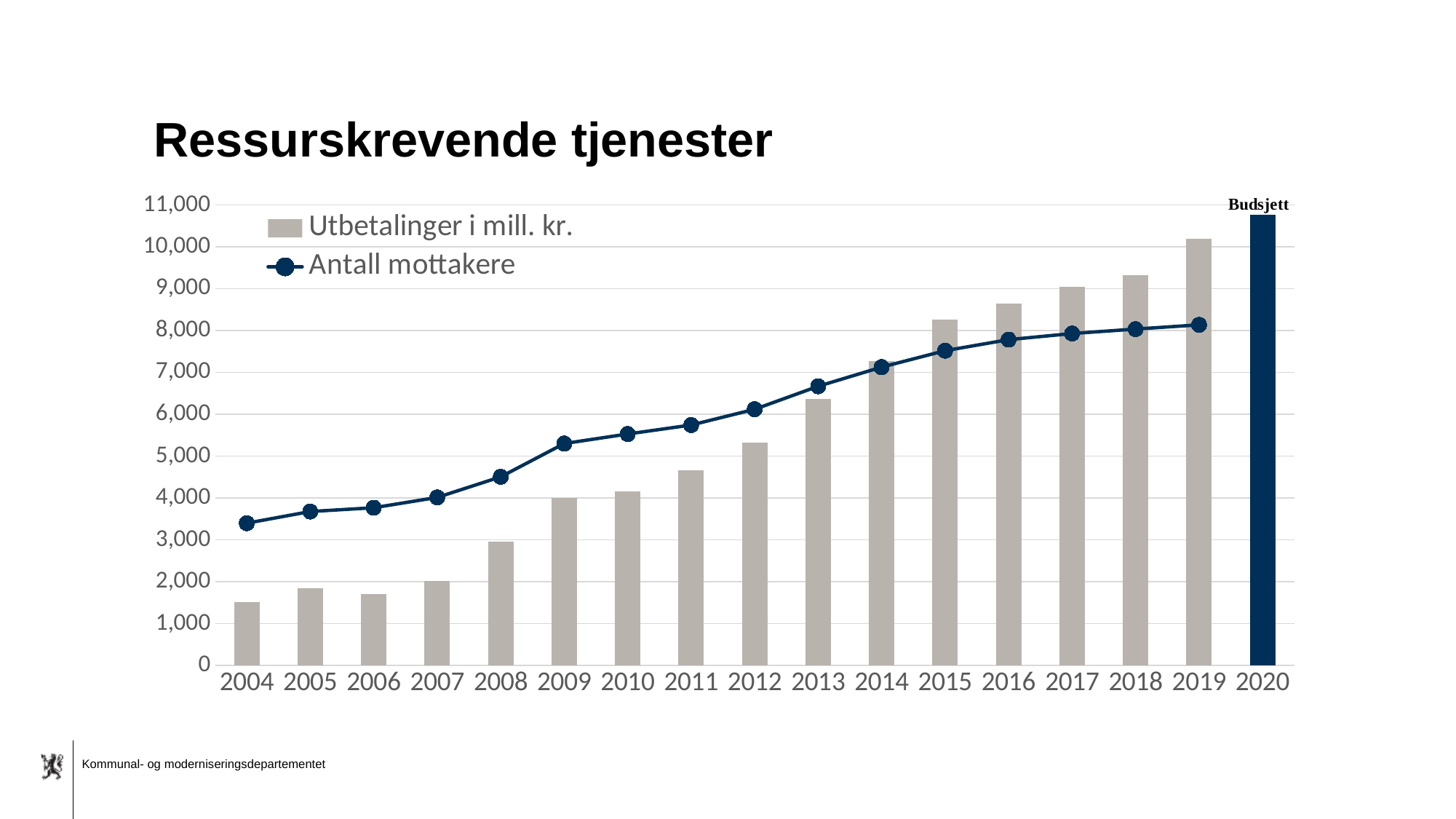
Do the Antall mottakere values rise or fall from 2004 to 2019? rise Is the Utbetalinger i mill. kr. bar for 2019 greater or less than 10,000? greater Is the Utbetalinger i mill. kr. bar for 2004 greater or less than 2,000? less How many series does the legend list? 2 Which year has the lowest value for Antall mottakere? 2004 What kind of chart is this? Bar chart combined with a line Which year has the highest bar for Utbetalinger i mill. kr.? 2020 What are the two series named in the legend? Utbetalinger i mill. kr. and Antall mottakere What is the title of the chart? Ressurskrevende tjenester Is the Antall mottakere value for 2010 greater or less than 5,000? greater Which is larger, the Utbetalinger i mill. kr. bar for 2008 or for 2009? 2009 How many years are shown on the x axis? 17